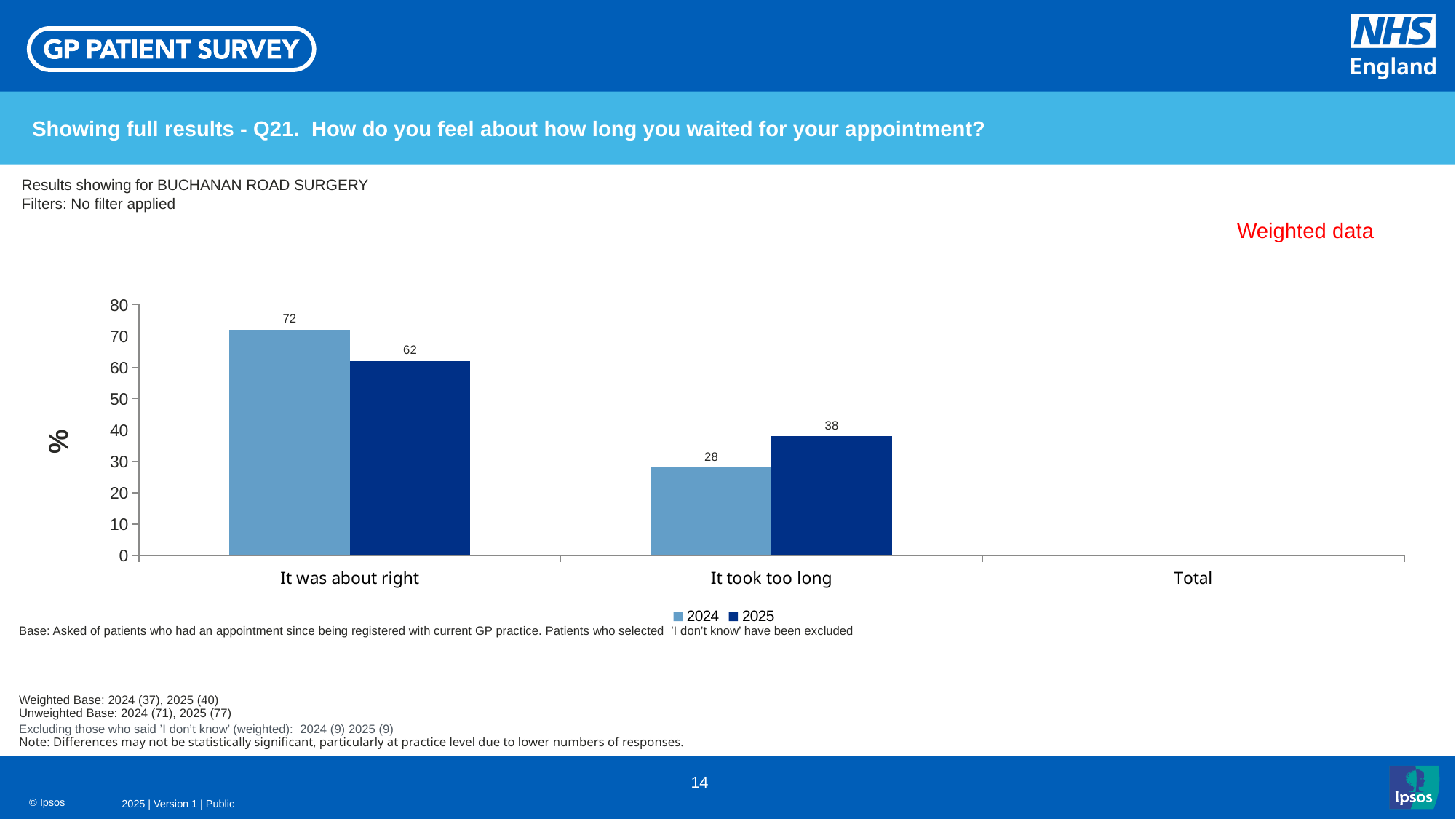
What is the 2024 value for 'It was about right'? 72 What is the difference between the 2024 and 2025 values for 'It was about right'? 10 How many series does the legend list? 2 What is the label on the vertical axis of the chart? % What is the 2025 value for 'It took too long'? 38 Did the value for 'It was about right' rise or fall from 2024 to 2025? Fall What is the 2024 value for 'It took too long'? 28 Which category has the lowest 2024 value? It took too long Which category has the highest 2025 value? It was about right What kind of chart is shown on the slide? Bar chart What is the 2025 value for 'It was about right'? 62 For 'It took too long', which year has the larger value, 2024 or 2025? 2025